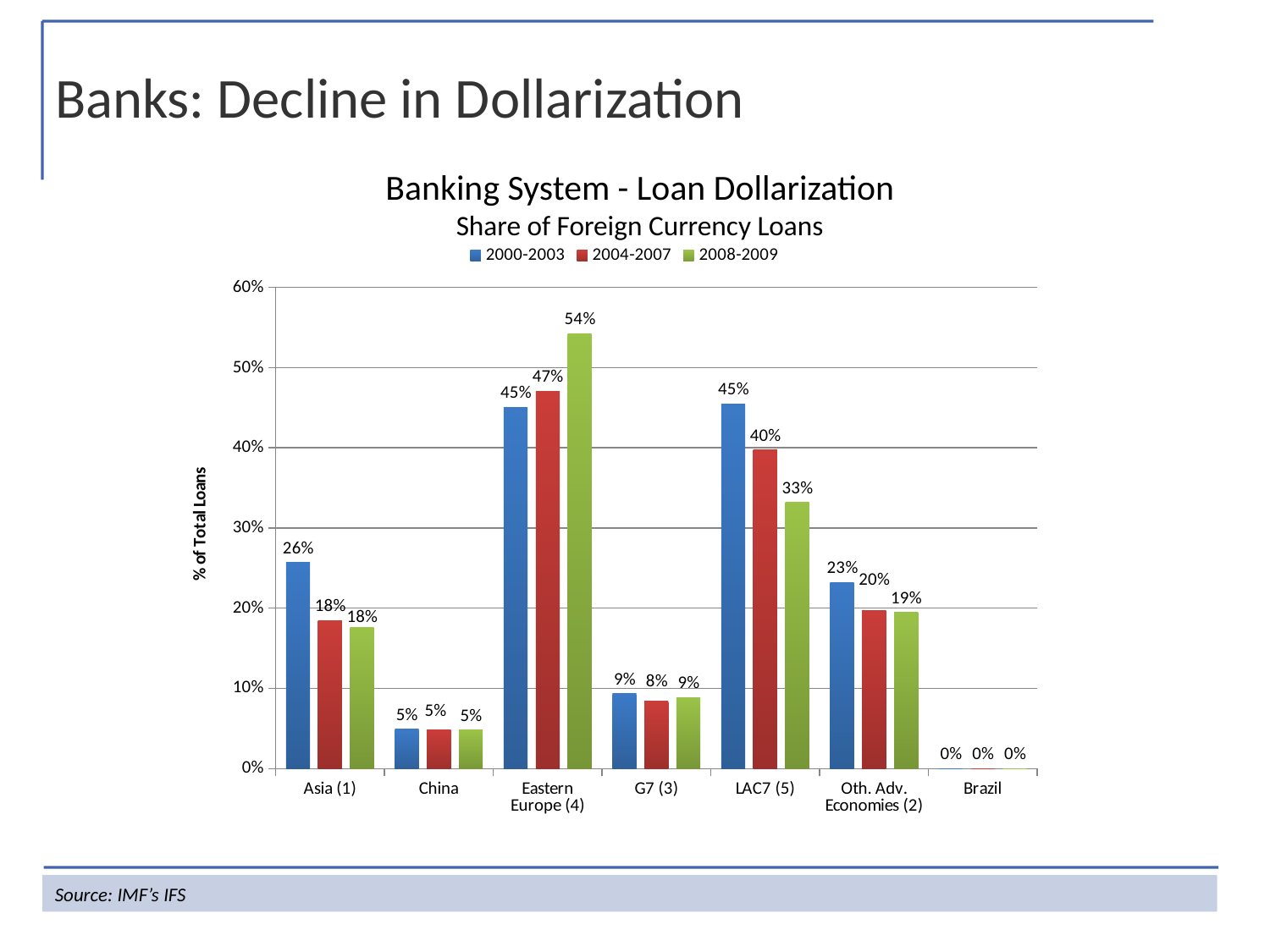
Which is larger for Asia (1): the 2000-2003 value or the 2004-2007 value? 2000-2003 What is the value for LAC7 (5) in the 2000-2003 series? 45% How many categories are shown on the x axis? 7 Which category has the highest value in the 2008-2009 series? Eastern Europe (4) What is the difference between the 2000-2003 and 2008-2009 values for LAC7 (5)? 12% Which category has the lowest values across all three periods? Brazil What kind of chart is shown on the slide? Bar chart What is the share of foreign currency loans for Eastern Europe (4) in 2008-2009? 54% What is the value for Asia (1) in 2000-2003? 26% What is the value for Oth. Adv. Economies (2) in 2004-2007? 20% How many series does the legend list? 3 What is the label of the y axis? % of Total Loans